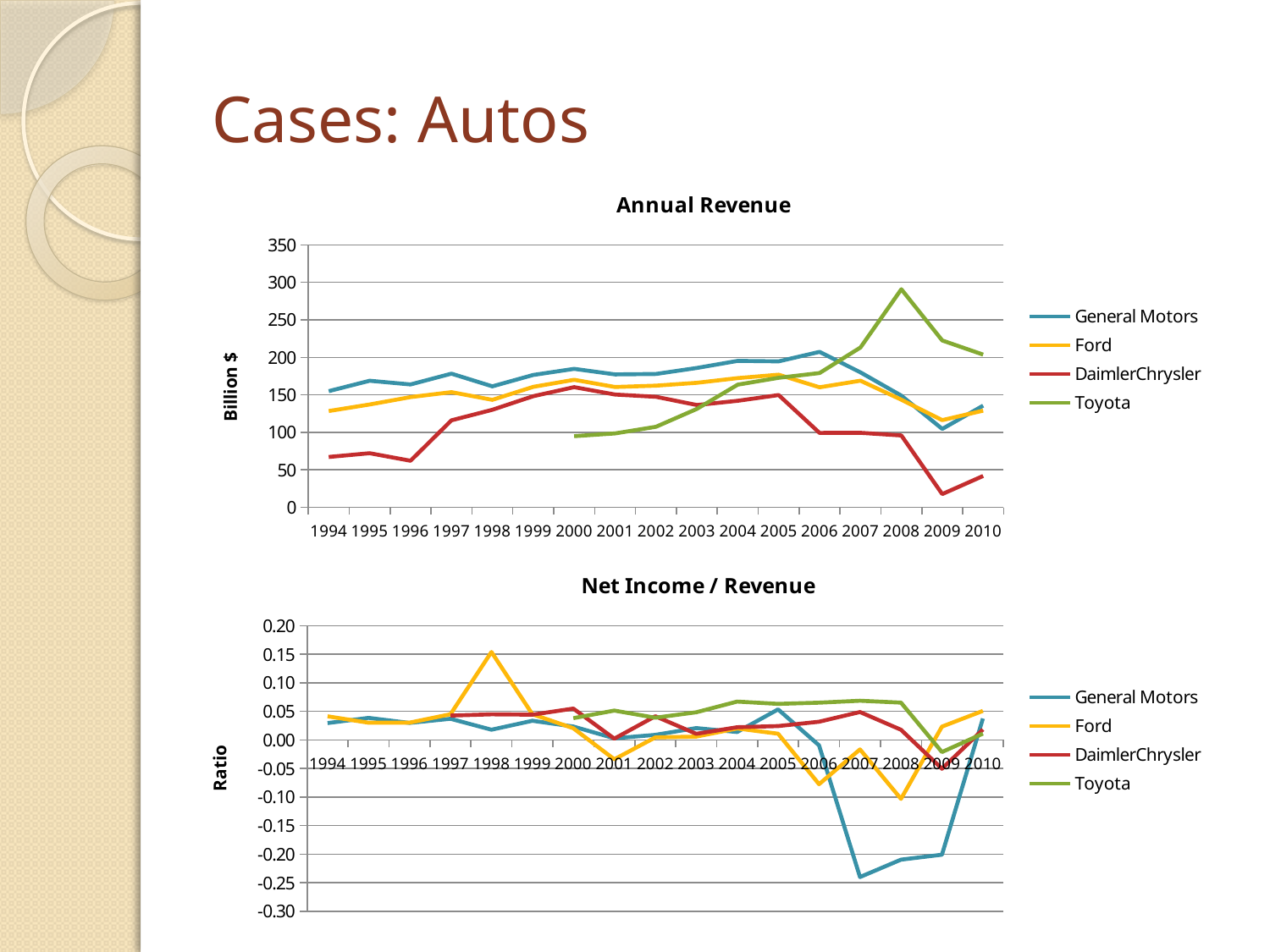
In the Net Income / Revenue chart, which company has the lowest ratio in 2007? General Motors In the Annual Revenue chart, does DaimlerChrysler's revenue rise or fall from 2005 to 2009? fall In the Annual Revenue chart, is the value for Ford in 1994 greater or less than 150? less In the Net Income / Revenue chart, is the value for General Motors in 2007 greater or less than -0.20? less What kind of chart is the Annual Revenue chart? line chart What is the y-axis label of the Annual Revenue chart? Billion $ How many series does the legend of the Annual Revenue chart list? 4 How many years are shown on the x axis of the Net Income / Revenue chart? 17 In the Annual Revenue chart, which company has the lowest revenue in 1994? DaimlerChrysler In the Annual Revenue chart, is the value for Toyota in 2008 greater or less than 250? greater In the Annual Revenue chart, which company has the highest revenue in 2008? Toyota